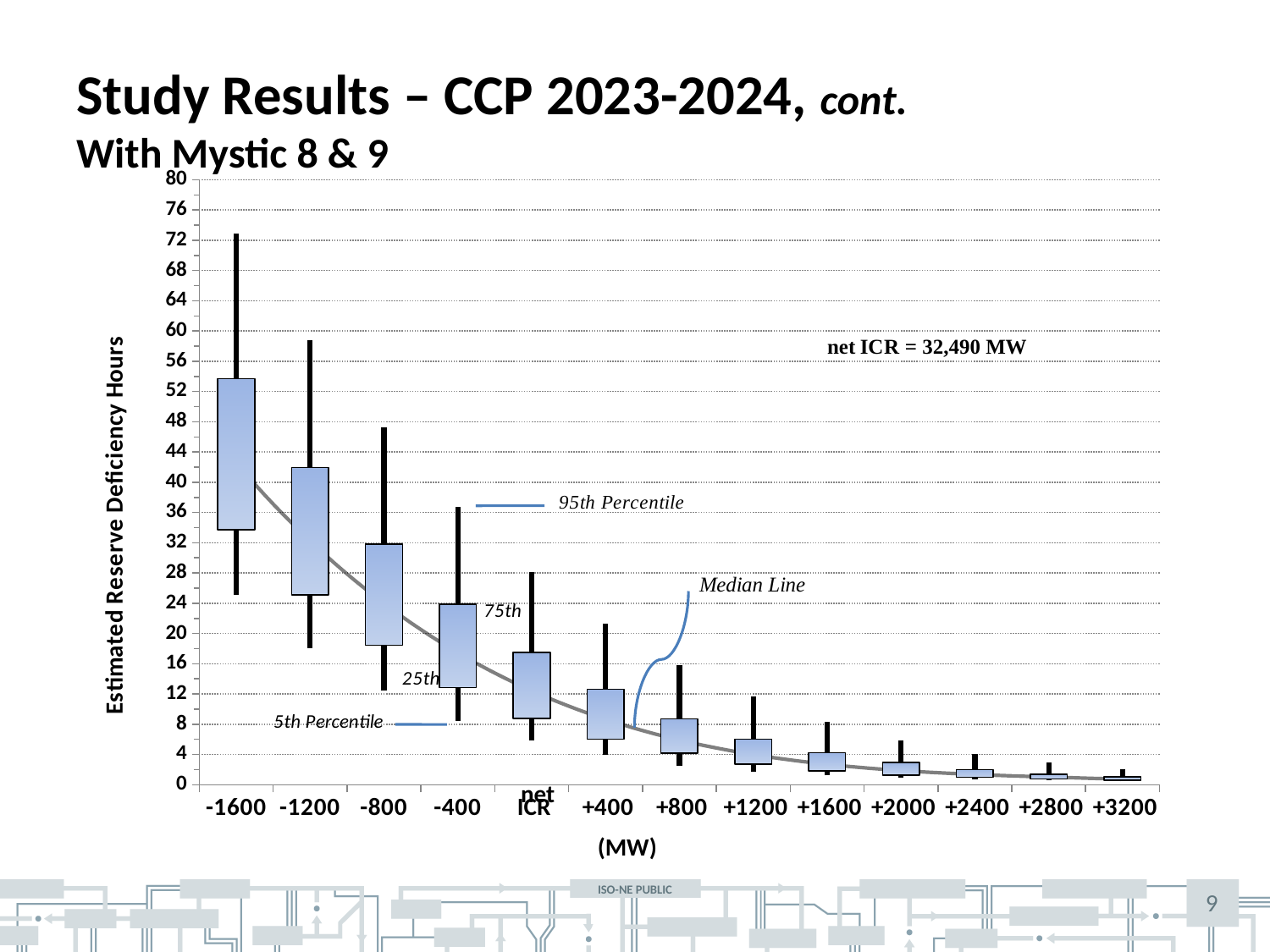
Is the 95th percentile value for -1600 MW greater or less than 60 hours? greater Which MW category has the lowest estimated reserve deficiency hours? +3200 What is the title of the y axis? Estimated Reserve Deficiency Hours Is the 95th percentile value for net ICR greater or less than 32 hours? less Is the 75th percentile value for +400 MW greater or less than 16 hours? less What net ICR value is stated in the annotation on the chart? 32,490 MW Do the estimated reserve deficiency hours rise or fall as the MW value increases along the x axis? Fall Which has the larger median estimated reserve deficiency hours, -1200 MW or +800 MW? -1200 What kind of chart is shown on the slide? Box plot (box-and-whisker chart) Which MW category has the highest 95th percentile of estimated reserve deficiency hours? -1600 How many MW categories are shown along the x axis? 13